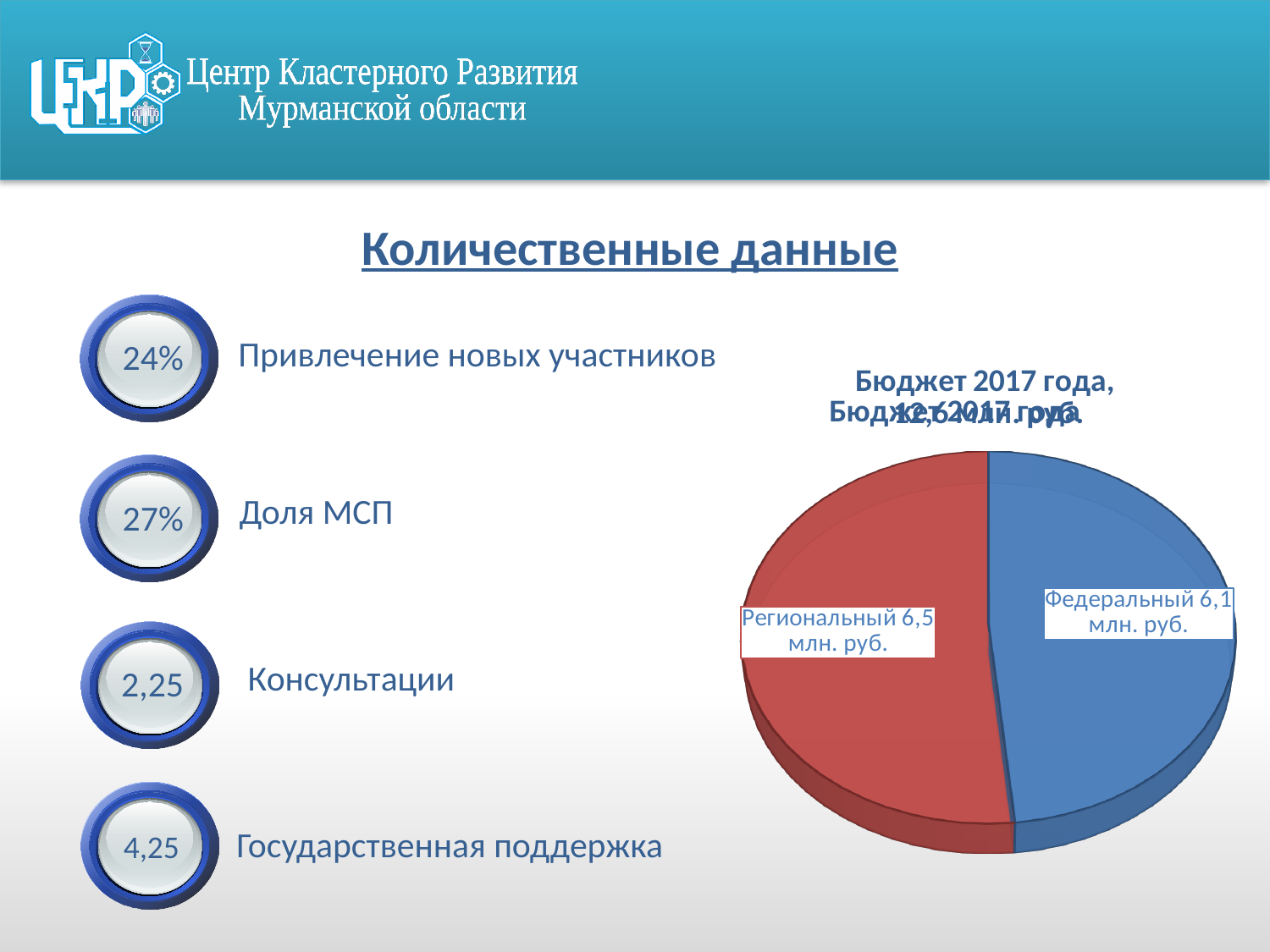
Which is larger in the pie chart, Региональный or Федеральный? Региональный What is the total of the two slices in the pie chart? 12,6 млн. руб. Which slice of the pie chart is the smallest? Федеральный How many slices does the pie chart have? 2 What colour is the Федеральный slice in the pie chart? blue What is the difference between the Региональный and Федеральный values in the pie chart? 0,4 млн. руб. Which slice of the pie chart is the largest? Региональный What kind of chart is shown on the slide? pie chart What is the value of the Региональный slice in the pie chart? 6,5 млн. руб. What colour is the Региональный slice in the pie chart? red What is the value of the Федеральный slice in the pie chart? 6,1 млн. руб.